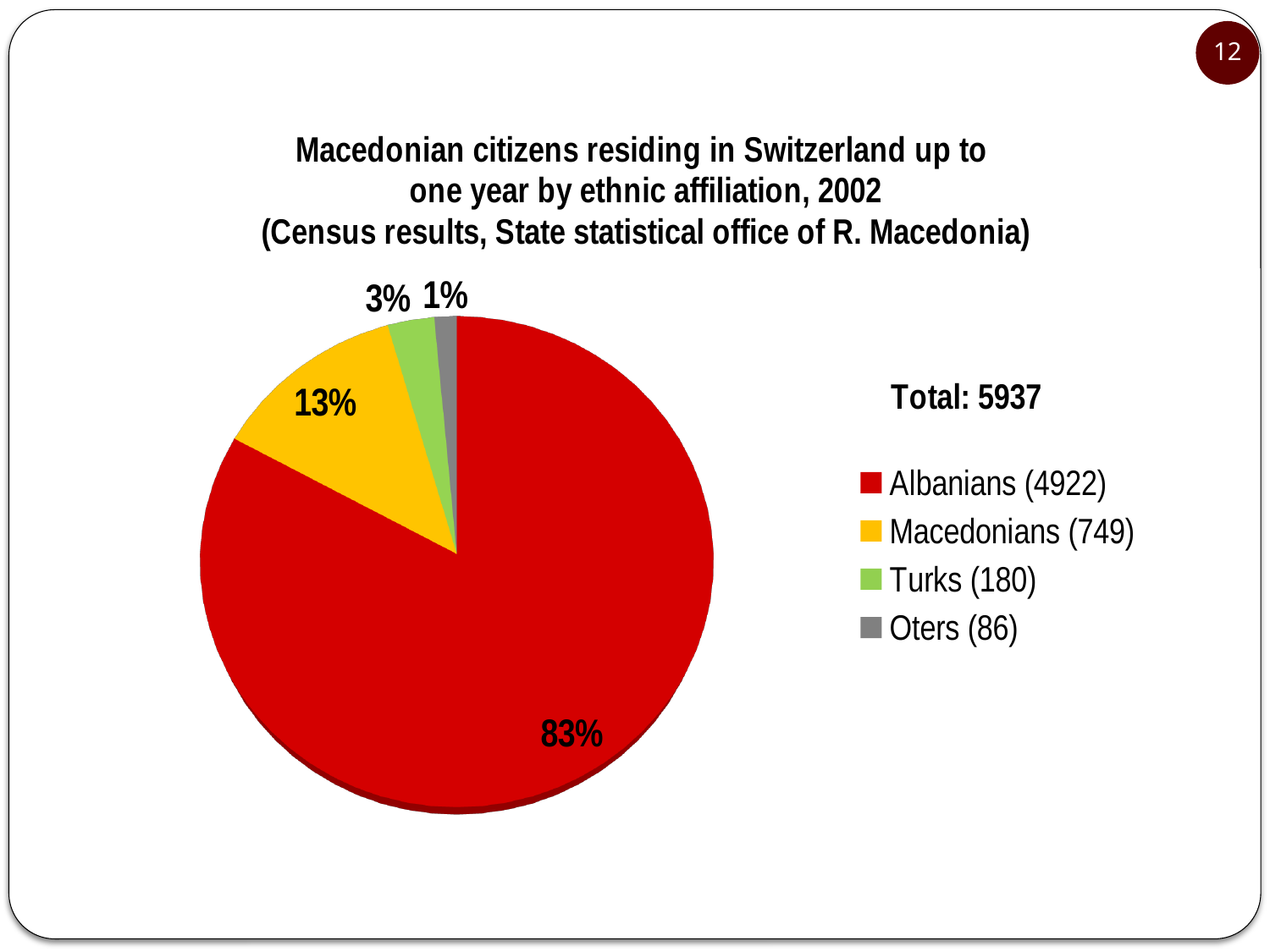
What percentage share of the pie do Macedonians have? 13% What is the number of Macedonians shown in the legend? 749 What total is stated next to the pie chart? 5937 What percentage share of the pie do Turks have? 3% What is the difference in percentage points between the Albanians slice and the Macedonians slice? 70 Which slice is larger, Turks or Macedonians? Macedonians Which ethnic group has the largest slice of the pie? Albanians Which ethnic group has the smallest slice of the pie? Oters What kind of chart is shown on the slide? pie chart What percentage share of the pie do Albanians have? 83% How many slices does the pie chart have? 4